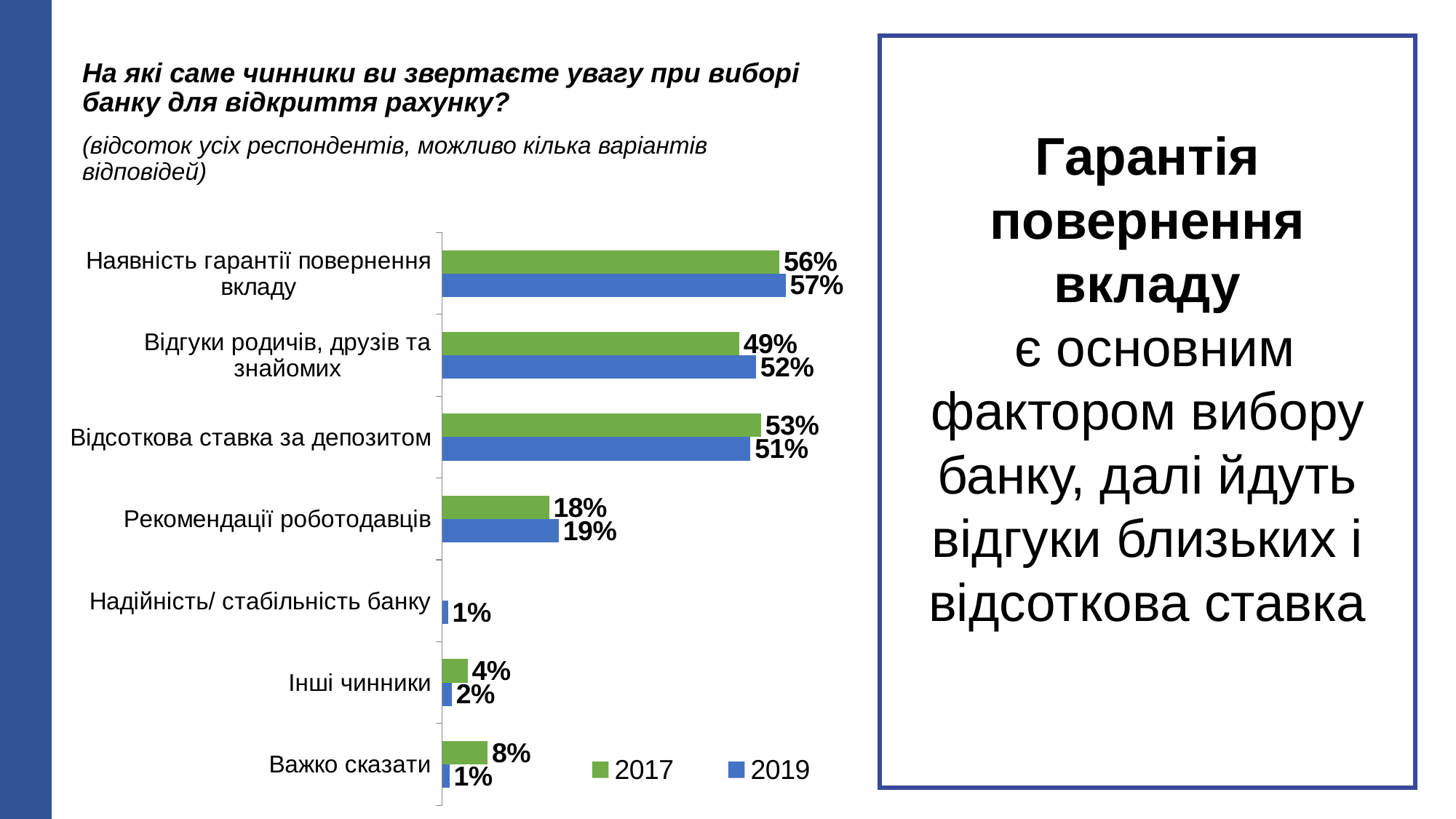
Which category has the lowest 2017 value among those with a 2017 bar? Інші чинники What is the 2017 value for "Відгуки родичів, друзів та знайомих"? 49% What is the difference between the 2019 values for "Відгуки родичів, друзів та знайомих" and "Відсоткова ставка за депозитом"? 1% Which is larger for "Відсоткова ставка за депозитом": the 2017 value or the 2019 value? 2017 What is the difference between the 2017 and 2019 values for "Важко сказати"? 7% Which category has the highest 2019 value? Наявність гарантії повернення вкладу How many categories are shown on the chart? 7 What type of chart is shown on the slide? bar chart What is the 2019 value for "Наявність гарантії повернення вкладу"? 57% What is the 2019 value for "Рекомендації роботодавців"? 19% How many series does the legend list? 2 Which colour represents the 2019 series in the legend? blue